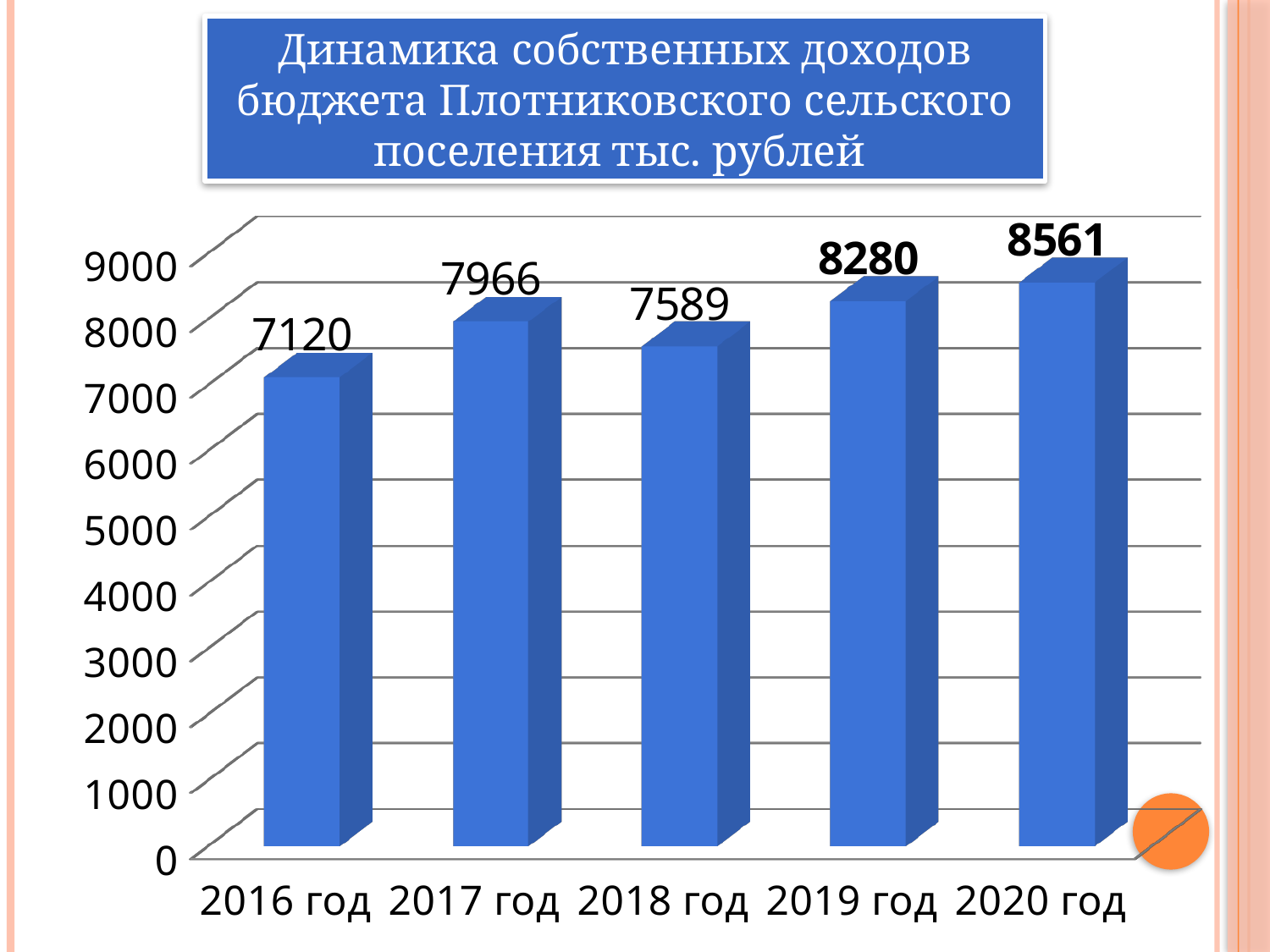
What is the difference between the values for 2017 год and 2018 год? 377 Which year has the highest value? 2020 год What is the difference between the values for 2020 год and 2016 год? 1441 Which is larger, the value for 2017 год or the value for 2018 год? 2017 год What is the value for 2018 год? 7589 What is the value for 2016 год? 7120 What is the value for 2020 год? 8561 What is the title of the chart? Динамика собственных доходов бюджета Плотниковского сельского поселения тыс. рублей How many years are shown on the chart? 5 Is the value for 2019 год greater or less than 8000? greater What kind of chart is shown on the slide? bar chart Which year has the lowest value? 2016 год